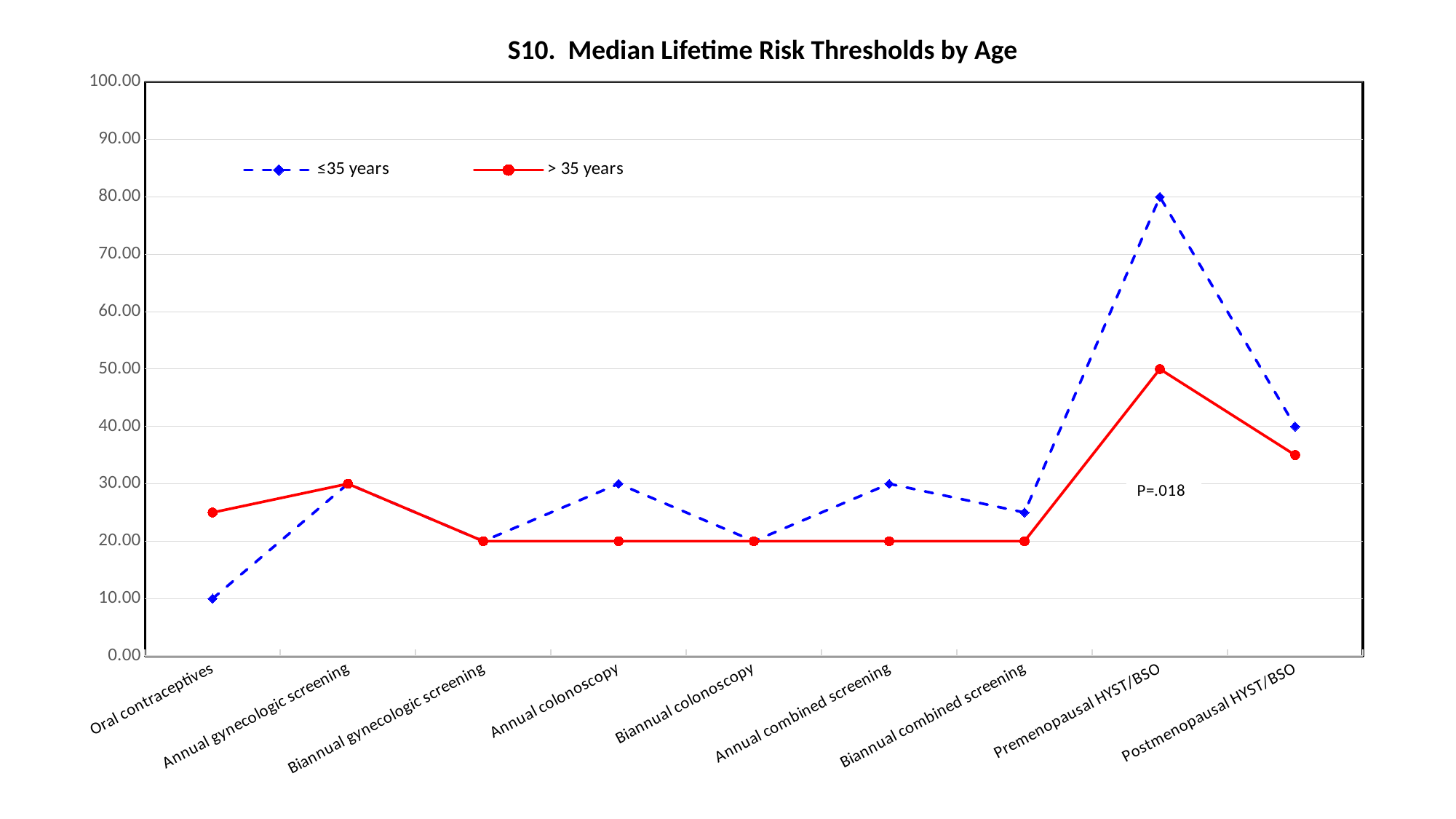
What is the value for Premenopausal HYST/BSO in the > 35 years series? 50.00 For the ≤35 years series, which category has the highest value? Premenopausal HYST/BSO What kind of chart is shown on the slide? line chart What is the difference between the ≤35 years and > 35 years values for Premenopausal HYST/BSO? 30.00 For the ≤35 years series, which category has the lowest value? Oral contraceptives How many categories are plotted along the x axis? 9 For the > 35 years series, which category has the highest value? Premenopausal HYST/BSO Is the value for Postmenopausal HYST/BSO in the > 35 years series greater or less than 40? less How many series does the legend list? 2 For Oral contraceptives, which series has the larger value, ≤35 years or > 35 years? > 35 years What is the value for Premenopausal HYST/BSO in the ≤35 years series? 80.00 What is the title of the chart? S10. Median Lifetime Risk Thresholds by Age